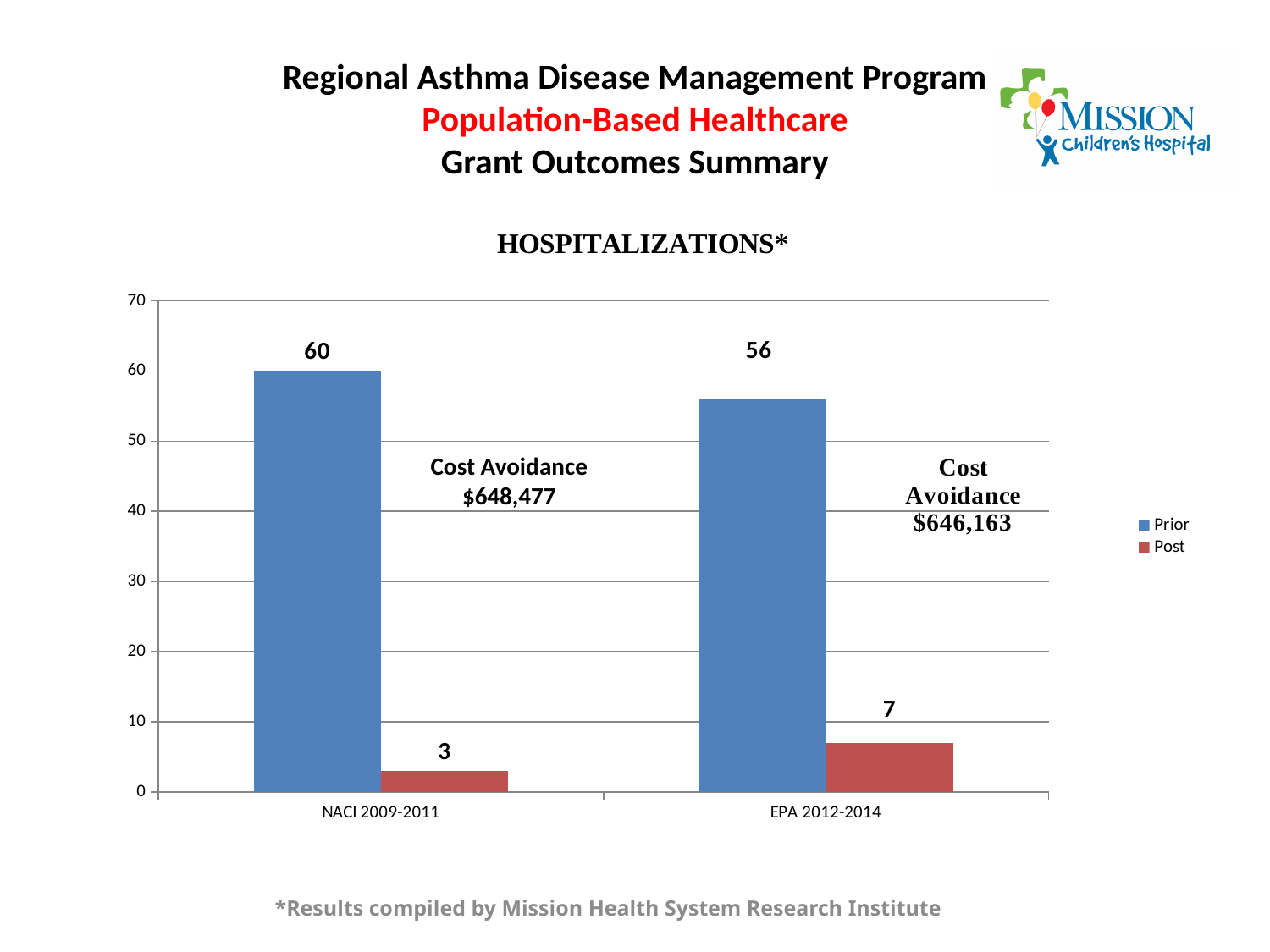
What is the difference between the Prior values for NACI 2009-2011 and EPA 2012-2014? 4 How many series does the legend list? 2 What is the difference between the Prior and Post values for NACI 2009-2011? 57 What is the Post value for EPA 2012-2014? 7 What is the Prior value for NACI 2009-2011? 60 What kind of chart is shown on the slide? Bar chart Which is larger, the Post value for EPA 2012-2014 or the Post value for NACI 2009-2011? EPA 2012-2014 Which category has the highest Prior value? NACI 2009-2011 How many categories are shown on the x axis? 2 Which category has the lowest Post value? NACI 2009-2011 What is the Post value for NACI 2009-2011? 3 What is the Prior value for EPA 2012-2014? 56